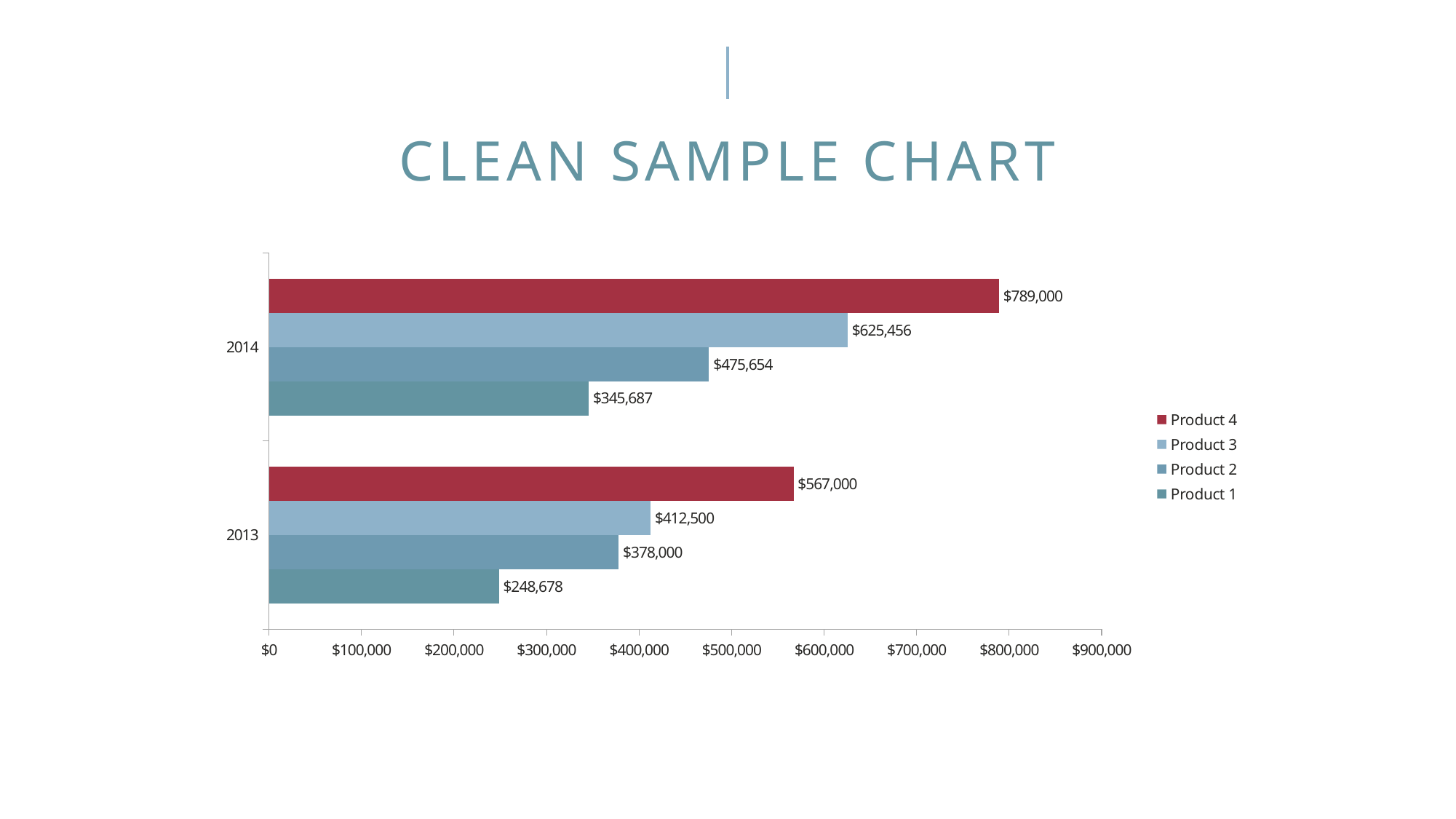
What kind of chart is shown on the slide? Bar chart What is the difference between Product 2 and Product 1 in 2013? $129,322 How many year categories are shown on the chart? 2 Which is larger: Product 3 in 2013 or Product 2 in 2014? Product 2 in 2014 Which product has the highest value in 2014? Product 4 Which product has the lowest value in 2013? Product 1 What is the difference between Product 4 in 2014 and Product 4 in 2013? $222,000 What is the value for Product 4 in 2014? $789,000 What is the value for Product 1 in 2013? $248,678 How many series does the legend list? 4 What is the title of the slide? CLEAN SAMPLE CHART What is the value for Product 3 in 2013? $412,500